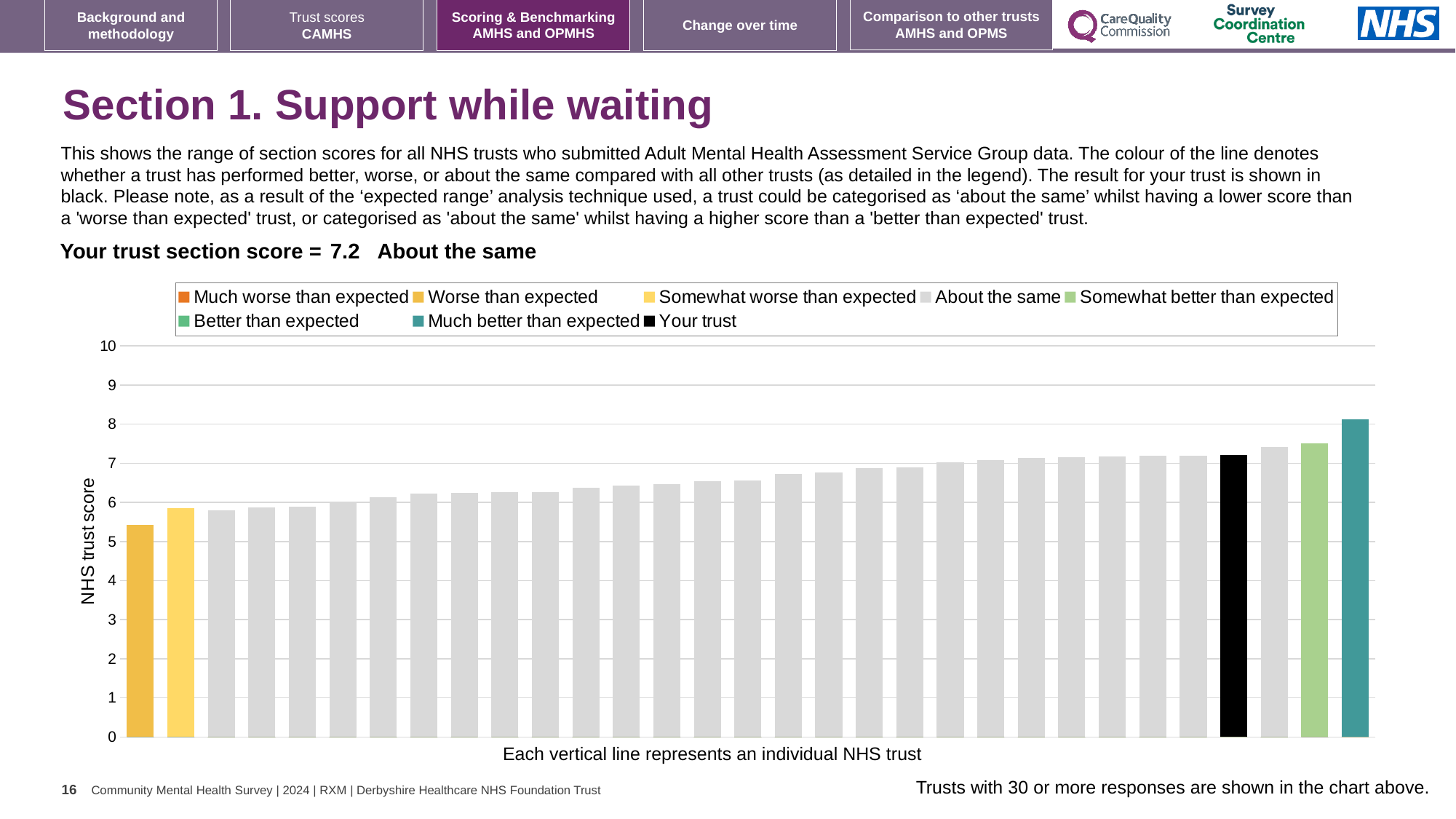
Which is larger: the black bar for your trust or the leftmost bar? the black bar for your trust Which category does your trust's section score fall into according to the slide? About the same Is the value of the leftmost bar greater or less than 6? less How many entries does the chart legend list? 8 Is the value of the black bar (your trust) greater or less than 5? greater What is the label on the vertical axis of the chart? NHS trust score Is the value of the rightmost bar greater or less than 7? greater What is the section score for your trust shown on the slide? 7.2 What kind of chart is shown on the slide? bar chart Do the bar values rise or fall from left to right along the x axis? rise Which legend category does the highest bar belong to? Much better than expected Which legend category does the lowest bar belong to? Worse than expected